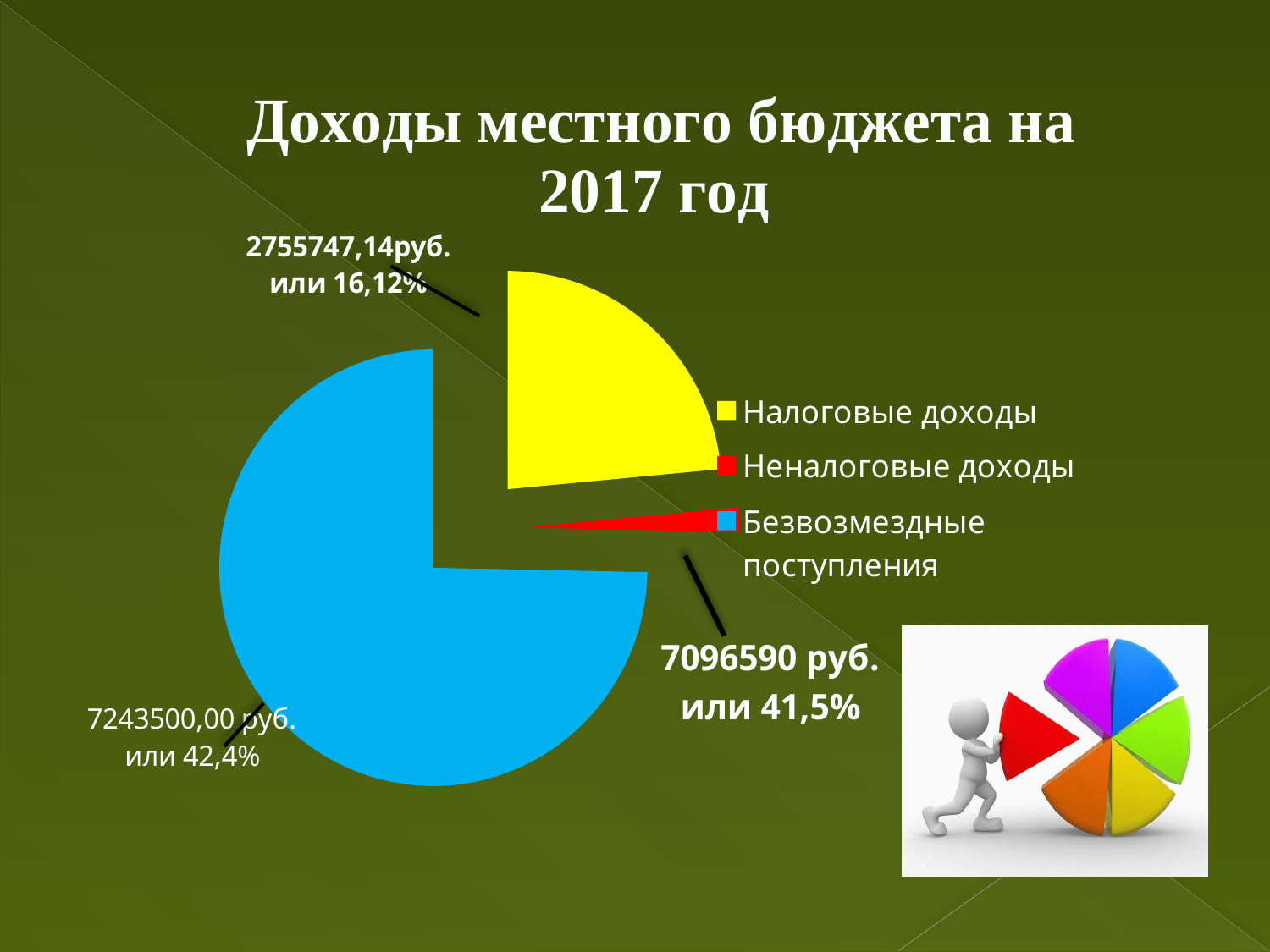
Which category occupies the smallest slice of the pie? Неналоговые доходы How many slices does the pie chart have? 3 What percentage is printed in the label attached to the yellow slice? 16,12% What percentage is printed in the label attached to the blue slice? 42,4% What kind of chart is shown on the slide? pie chart Which slice is larger, the yellow one or the red one? the yellow one Which category occupies the largest slice of the pie? Безвозмездные поступления How many entries does the chart legend list? 3 What amount in rubles is printed in the label attached to the yellow slice? 2755747,14руб. What amount in rubles is printed in the label attached to the blue slice? 7243500,00 руб. What is the title of the chart on the slide? Доходы местного бюджета на 2017 год Which colour represents Налоговые доходы in the legend? yellow